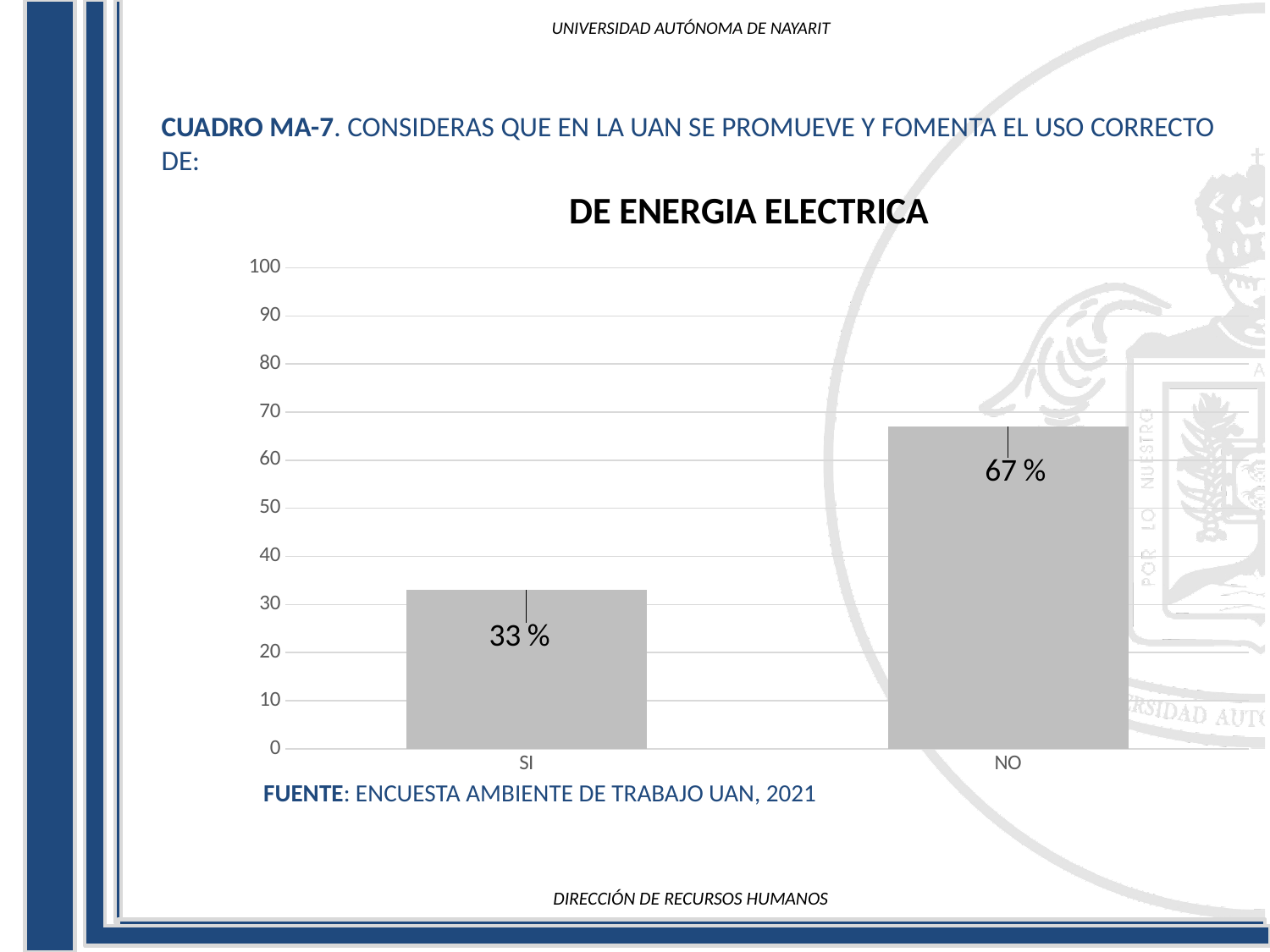
What is the title of the chart? DE ENERGIA ELECTRICA Which category has the lowest value? SI Is the value for NO greater or less than 60? greater What kind of chart is shown on the slide? bar chart How many categories are shown on the x axis? 2 What is the value for NO? 67 % Is the value for SI greater or less than 40? less Which category has the highest value? NO What is the difference between the values for NO and SI? 34 % Which is larger, the value for SI or the value for NO? NO What is the value for SI? 33 % What is the highest value shown on the y axis? 100